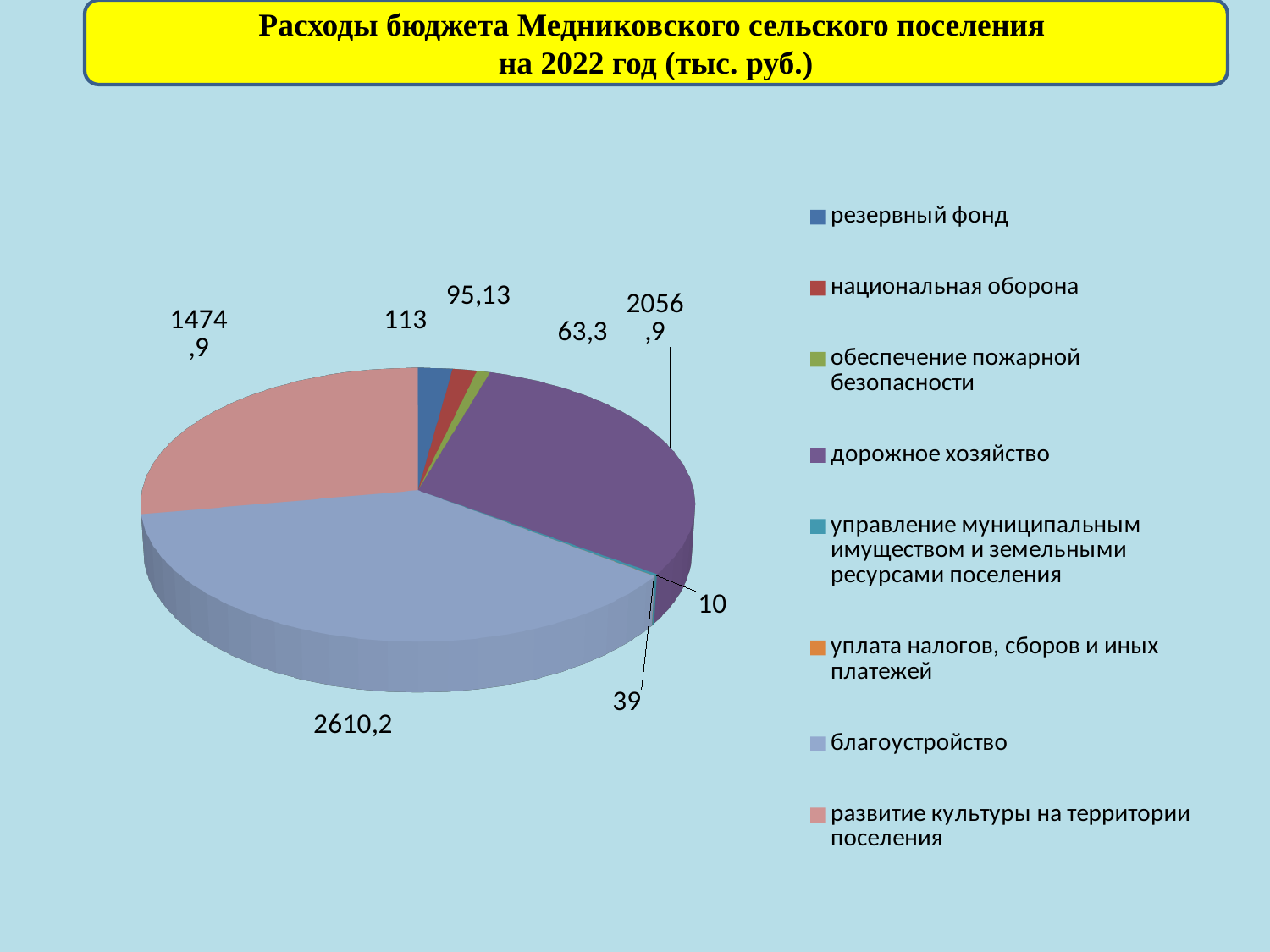
Which is larger, the value for резервный фонд or the value for обеспечение пожарной безопасности? резервный фонд What kind of chart is shown on the slide? pie chart How many categories does the legend list? 8 Which category has the largest slice of the pie? благоустройство What is the value for дорожное хозяйство? 2056,9 What is the difference between the values for благоустройство and дорожное хозяйство? 553,3 What is the value for развитие культуры на территории поселения? 1474,9 What is the value for национальная оборона? 95,13 What is the title of the chart? Расходы бюджета Медниковского сельского поселения на 2022 год (тыс. руб.) What is the value for управление муниципальным имуществом и земельными ресурсами поселения? 10 What is the value for благоустройство? 2610,2